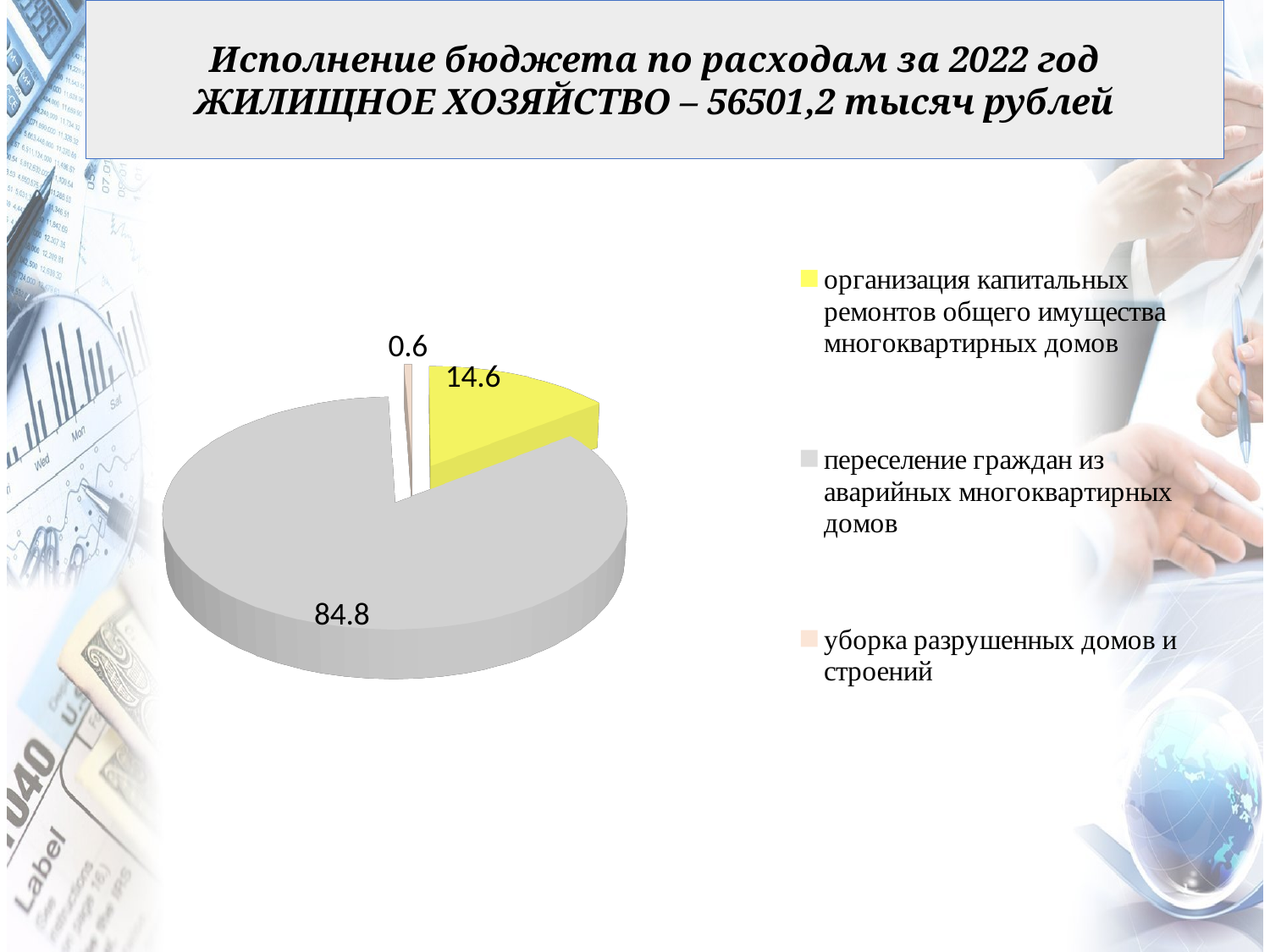
What is the value for "уборка разрушенных домов и строений"? 0.6 What is the value for "переселение граждан из аварийных многоквартирных домов"? 84.8 What is the value for "организация капитальных ремонтов общего имущества многоквартирных домов"? 14.6 What kind of chart is shown on the slide? pie chart What is the difference between the values for "переселение граждан из аварийных многоквартирных домов" and "организация капитальных ремонтов общего имущества многоквартирных домов"? 70.2 What is the difference between the values for "организация капитальных ремонтов общего имущества многоквартирных домов" and "уборка разрушенных домов и строений"? 14 Which category has the smallest slice of the pie? уборка разрушенных домов и строений How many slices does the pie chart have? 3 What colour is the slice for "организация капитальных ремонтов общего имущества многоквартирных домов"? yellow Which is larger: the value for "организация капитальных ремонтов общего имущества многоквартирных домов" or the value for "уборка разрушенных домов и строений"? организация капитальных ремонтов общего имущества многоквартирных домов Which category has the largest slice of the pie? переселение граждан из аварийных многоквартирных домов How many entries does the legend list? 3